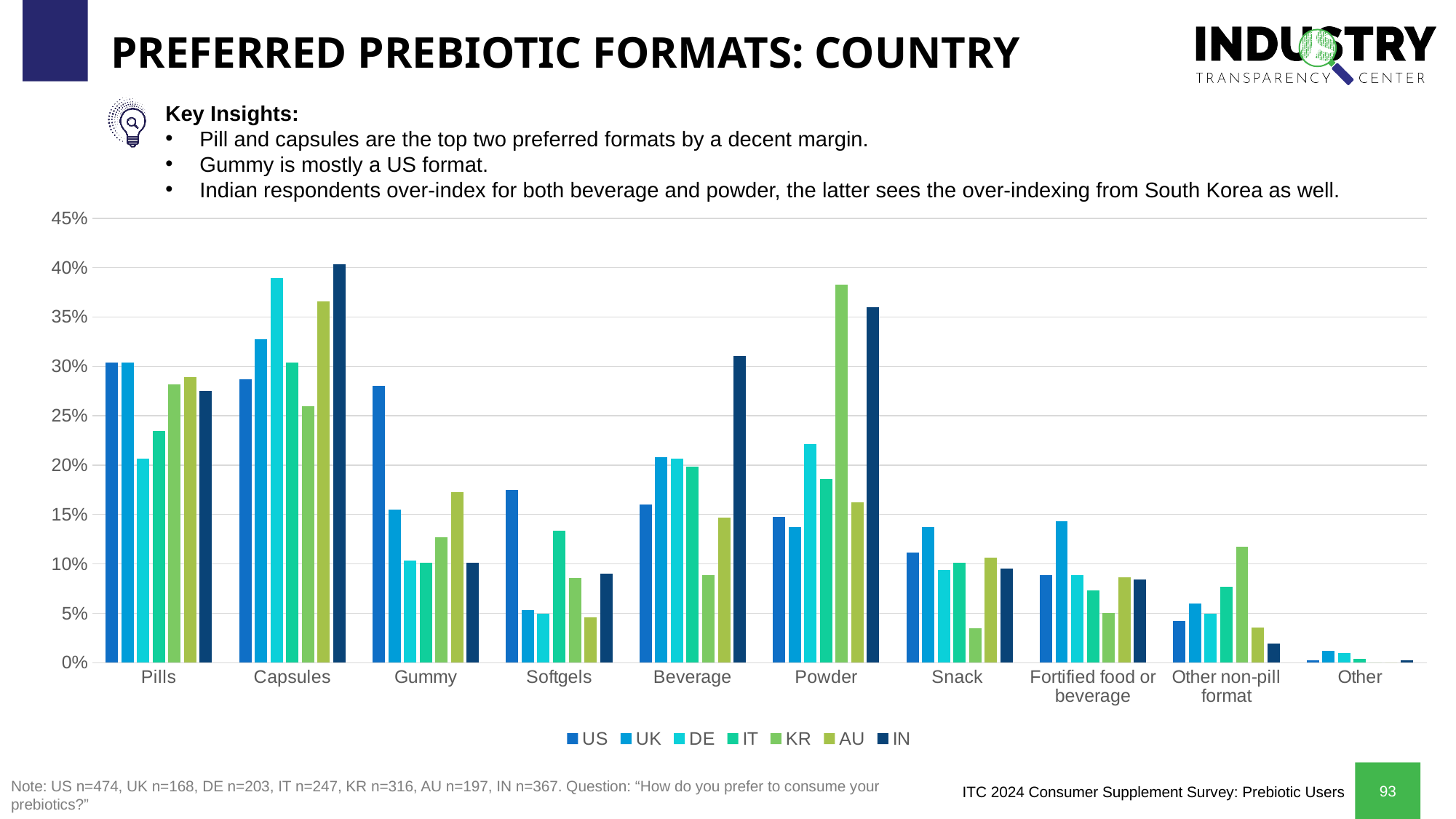
Is the value for US in the Gummy category greater or less than 25%? greater How many series does the legend list? 7 Is the value for IN in the Beverage category greater or less than 25%? greater Is the value for DE in the Capsules category greater or less than 35%? greater Which country has the highest value for Capsules? IN Which country has the lowest value for Snack? KR What is the title of the chart slide? PREFERRED PREBIOTIC FORMATS: COUNTRY Which country has the highest value for Powder? KR For Pills, which is larger: the value for KR or the value for DE? KR What kind of chart is shown on the slide? bar chart Which country has the highest value for Gummy? US How many format categories are shown on the x axis? 10